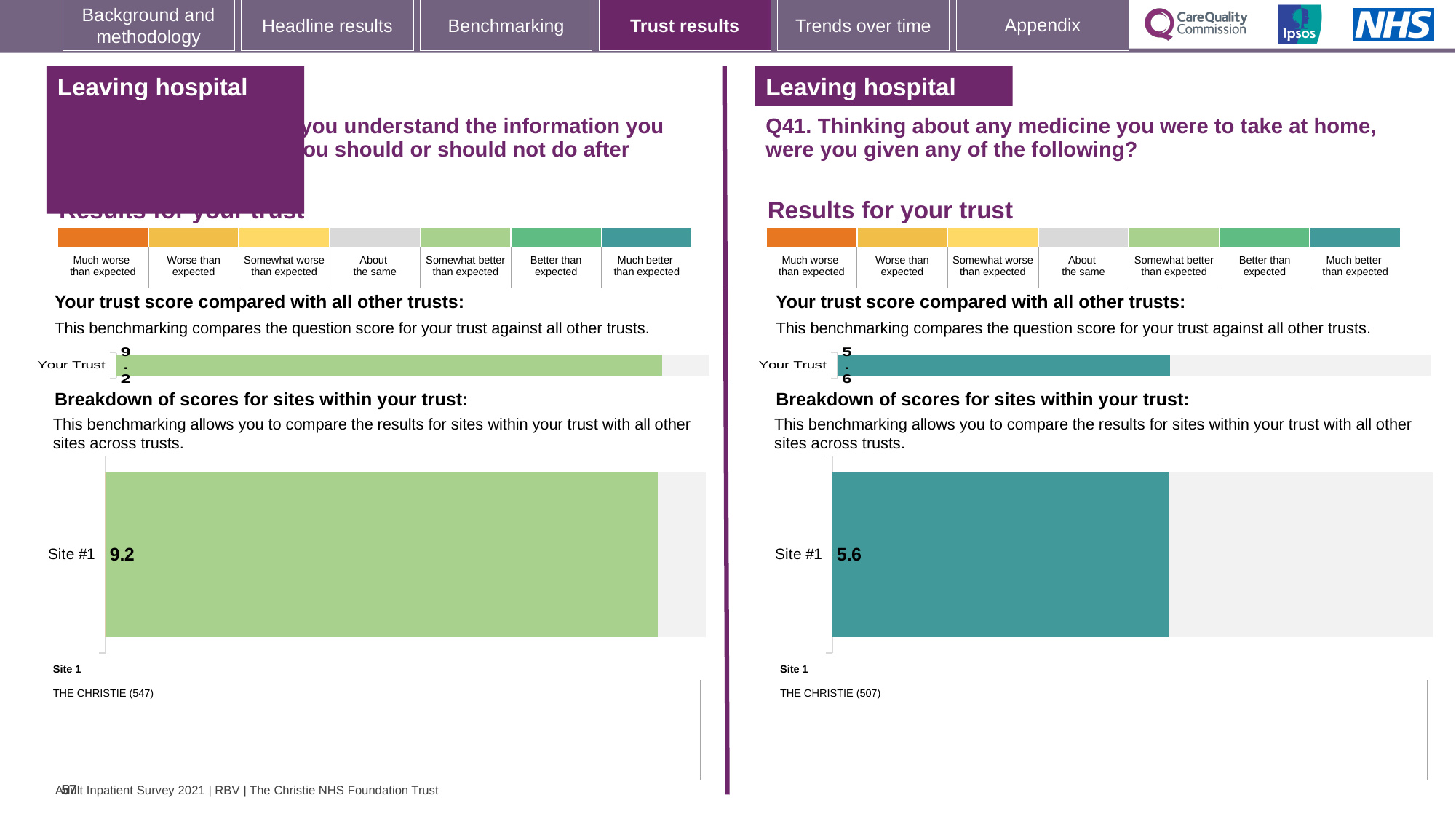
On the left-hand chart, what is the score shown for Your Trust? 9.2 On the right-hand chart (Q41), what is the score shown for Your Trust? 5.6 In the right-hand site breakdown chart (Q41), what is the score for Site #1? 5.6 What type of chart is used for the site breakdown on the right-hand side (Q41)? Bar chart In the left-hand site breakdown chart, what is the score for Site #1? 9.2 What is the difference between the Site #1 score on the left-hand chart and the Site #1 score on the right-hand chart (Q41)? 3.6 How many sites are shown in the left-hand site breakdown chart? 1 Which is larger: the Site #1 score on the left-hand chart or the Site #1 score on the right-hand chart (Q41)? Left-hand chart (9.2) Which site name is listed under Site 1 on the left-hand chart? THE CHRISTIE (547) Which site name is listed under Site 1 on the right-hand chart (Q41)? THE CHRISTIE (507) How many sites are shown in the right-hand site breakdown chart (Q41)? 1